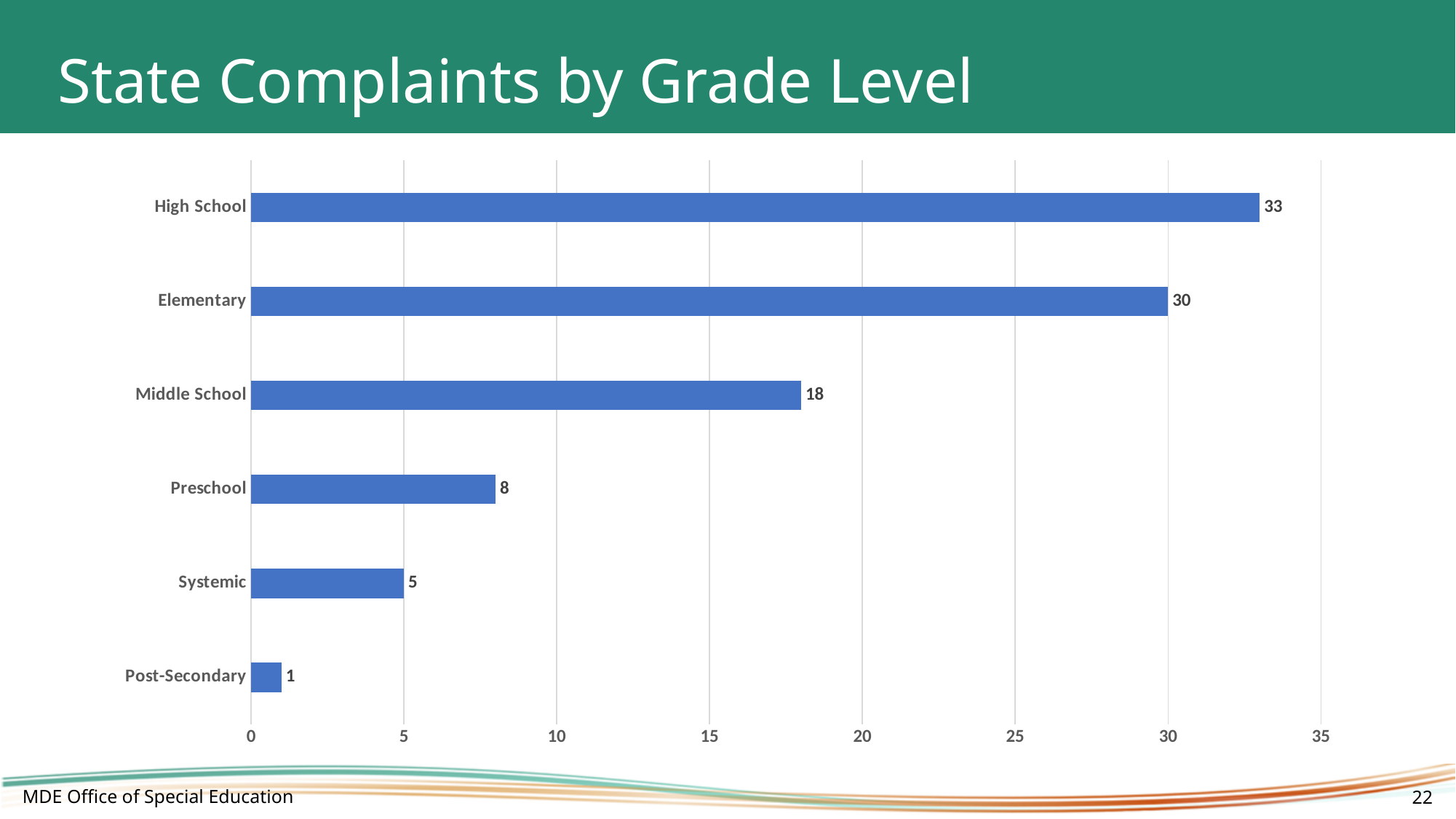
Which category has the lowest number of state complaints? Post-Secondary Which grade level has the highest number of state complaints? High School How many categories are shown in the chart? 6 What is the title of the slide? State Complaints by Grade Level What kind of chart is shown on the slide? Bar chart Is the value for Elementary greater or less than 25? greater How many state complaints were filed for High School? 33 What is the value for Preschool? 8 Which is larger, the value for Systemic or the value for Preschool? Preschool What is the difference between the Middle School and Preschool values? 10 What is the value for Middle School? 18 What is the difference between the High School and Elementary values? 3